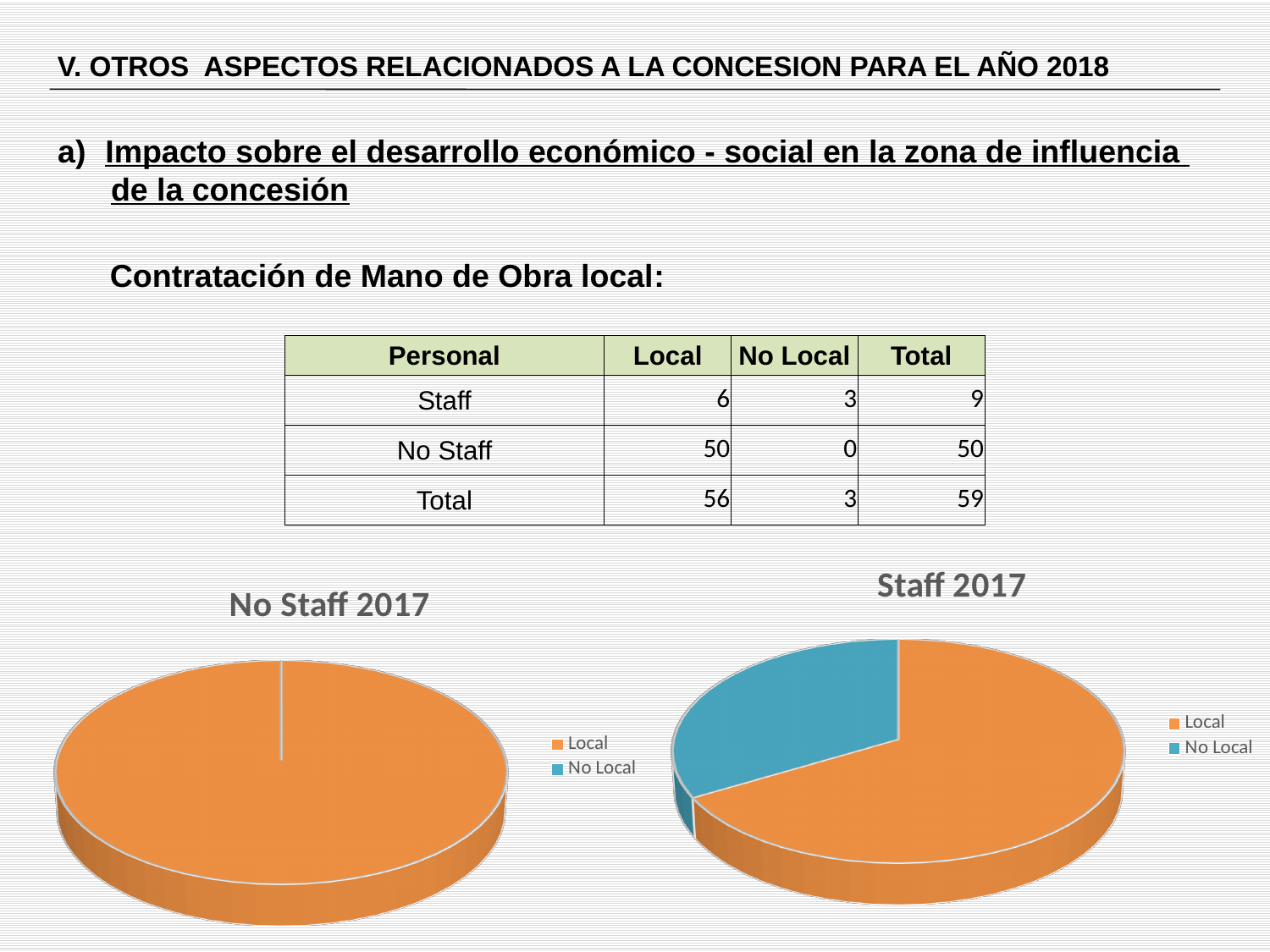
In the "Staff 2017" chart, which slice is larger, Local or No Local? Local In the "No Staff 2017" chart, which category takes up almost the entire pie? Local In the "Staff 2017" chart, which category has the largest slice? Local What kind of chart is the "Staff 2017" chart? Pie chart In the "Staff 2017" chart, how many entries does the legend list? 2 In the "Staff 2017" chart, which category has the smallest slice? No Local What are the legend entries of the "No Staff 2017" chart? Local, No Local In the "No Staff 2017" chart, how many entries does the legend list? 2 In the "Staff 2017" chart, what colour is the Local slice? Orange In the "Staff 2017" chart, is the Local slice more or less than half of the pie? More than half What kind of chart is the "No Staff 2017" chart? Pie chart In the "Staff 2017" chart, how many visible slices does the pie have? 2